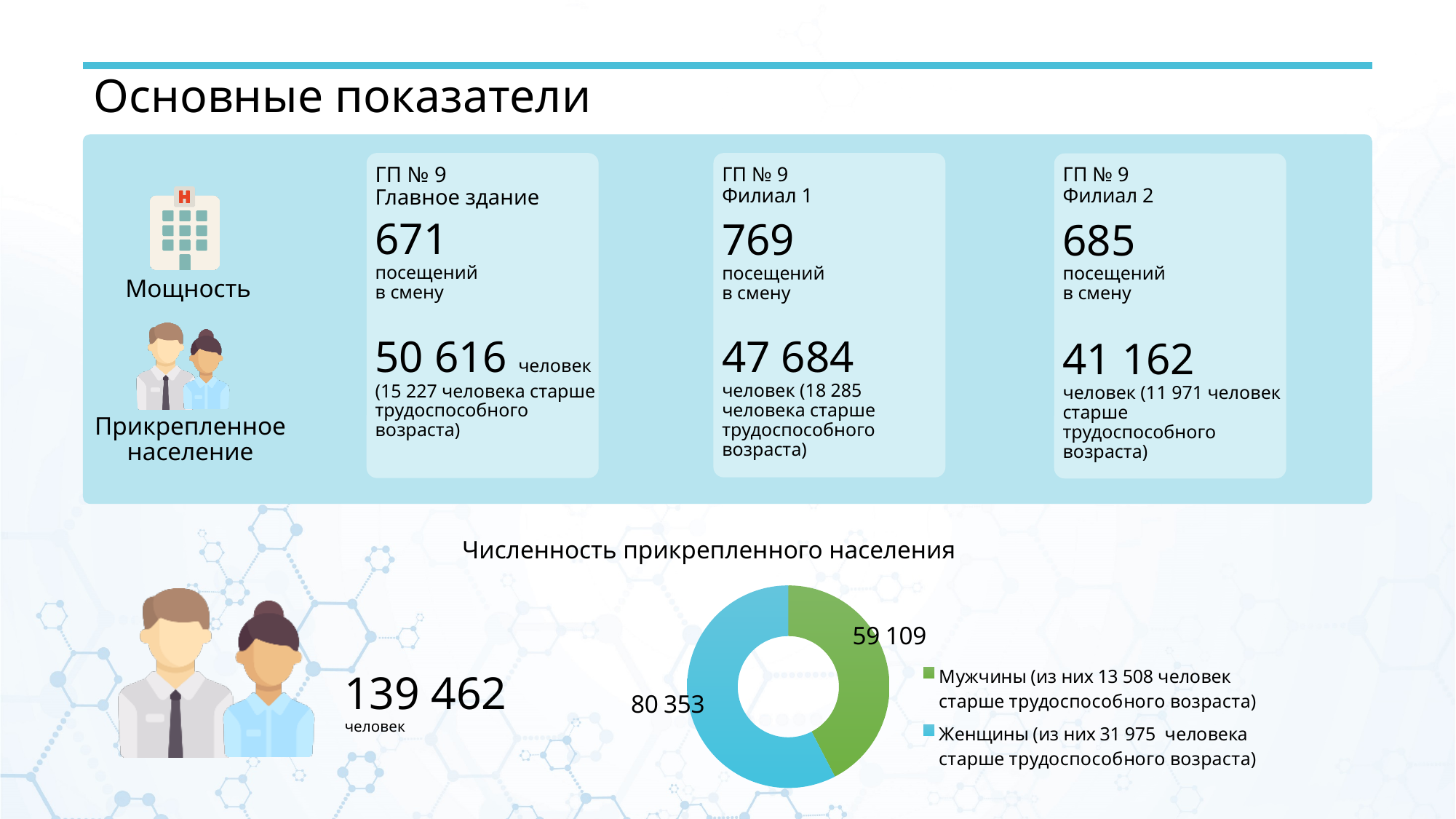
Which slice of the pie chart is the largest? Женщины Which slice of the pie chart is the smallest? Мужчины What is the value shown for Мужчины in the pie chart? 59 109 What is the total of the two slices in the pie chart? 139 462 What is the difference between the Женщины and Мужчины values in the pie chart? 21 244 How many slices does the pie chart have? 2 How many entries does the legend of the pie chart list? 2 What colour is the Мужчины slice in the pie chart? Green What share of the pie chart does the Женщины slice represent, to one decimal place? 57.6% Which is larger in the pie chart, Мужчины or Женщины? Женщины What type of chart is shown under the title "Численность прикрепленного населения"? Pie (doughnut) chart What is the value shown for Женщины in the pie chart? 80 353